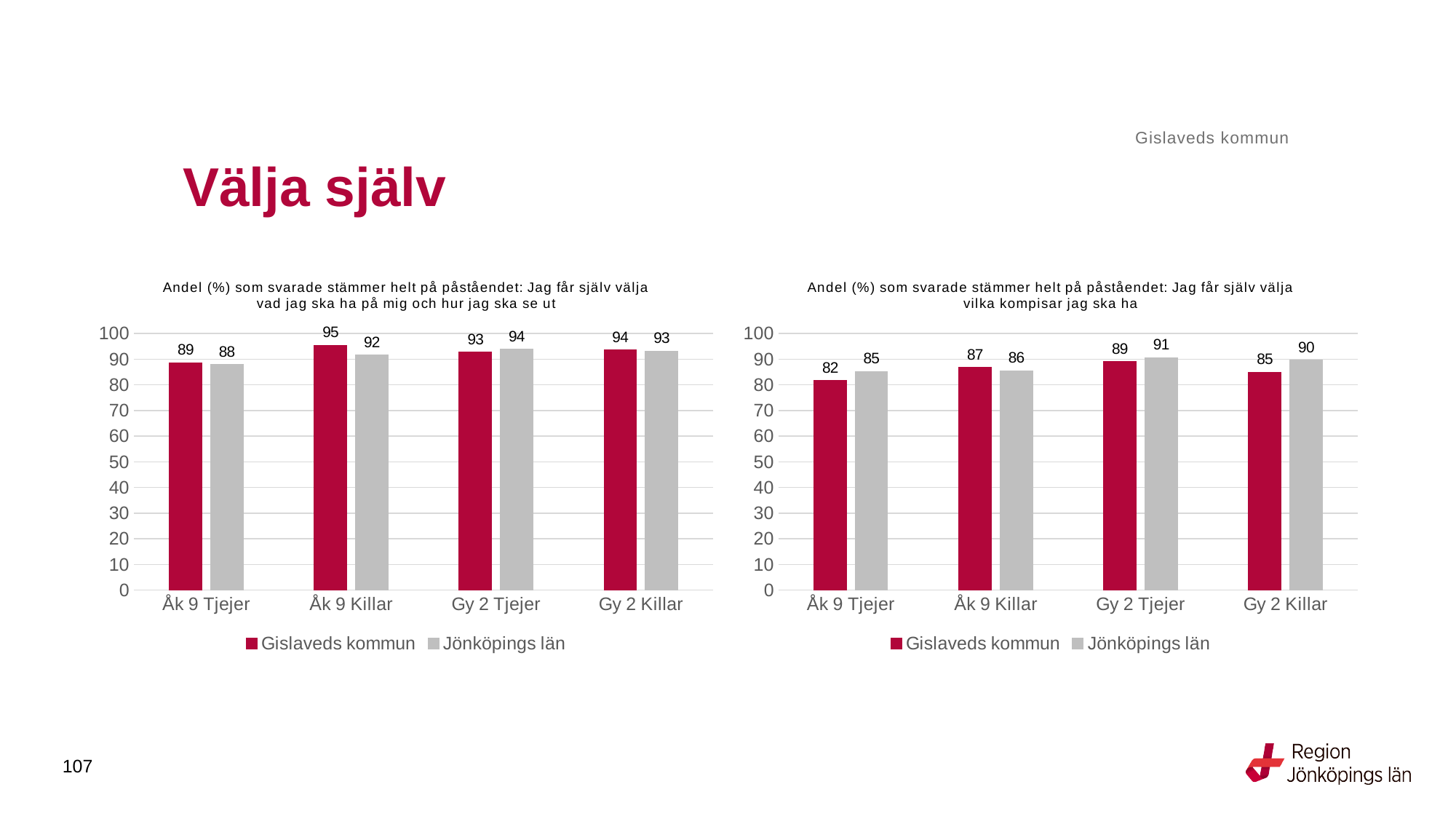
How many categories are shown on the x axis of the left chart? 4 In the left chart (about choosing what to wear and how to look), what is the difference between Gislaveds kommun and Jönköpings län for Åk 9 Killar? 3 What kind of chart is the left chart? Bar chart In the right chart (about choosing friends), what is the difference between Jönköpings län and Gislaveds kommun for Gy 2 Killar? 5 In the right chart (about choosing friends), which is larger for Gy 2 Tjejer: Gislaveds kommun or Jönköpings län? Jönköpings län In the left chart (about choosing what to wear and how to look), what is the value for Gislaveds kommun for Åk 9 Killar? 95 In the right chart (about choosing friends), what is the value for Jönköpings län for Gy 2 Killar? 90 How many series does the legend of the right chart list? 2 In the left chart (about choosing what to wear and how to look), what is the value for Jönköpings län for Åk 9 Tjejer? 88 In the right chart (about choosing friends), which category has the lowest value for Gislaveds kommun? Åk 9 Tjejer In the right chart (about choosing friends), what is the value for Gislaveds kommun for Åk 9 Tjejer? 82 In the left chart (about choosing what to wear and how to look), which category has the highest value for Gislaveds kommun? Åk 9 Killar